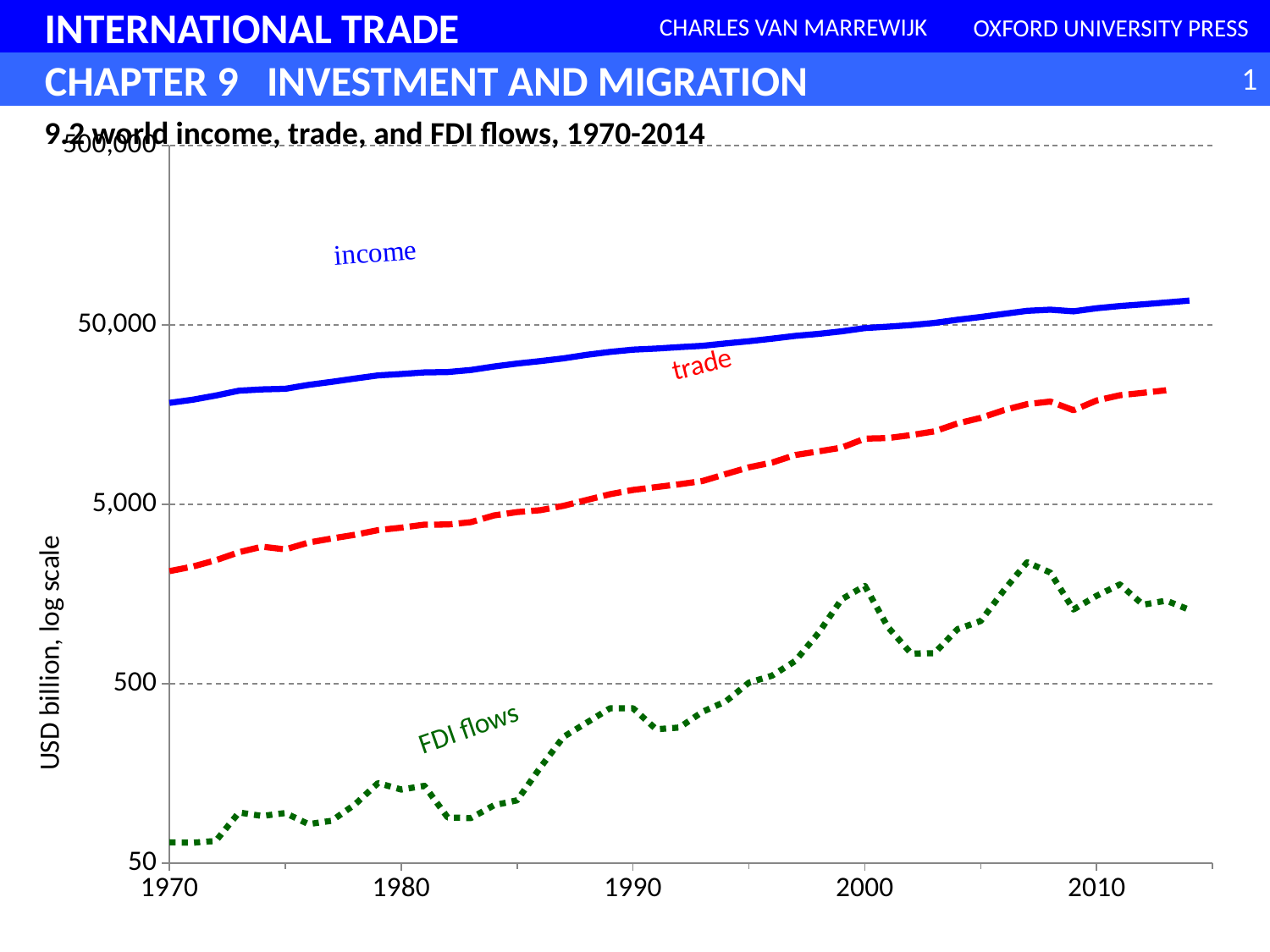
Does the income series rise or fall from 1970 to 2014? rise What is the label on the vertical axis of the chart? USD billion, log scale Is the value for income in 2010 greater or less than 50,000? greater Is the value for FDI flows in 2000 greater or less than 500? greater Is the value for trade in 1970 greater or less than 5,000? less How many series are plotted on the chart? 3 In 2000, which is larger: trade or FDI flows? trade Which series has the highest values across the whole period? income Which series has the lowest values across the whole period? FDI flows What kind of chart is shown on the slide? line chart